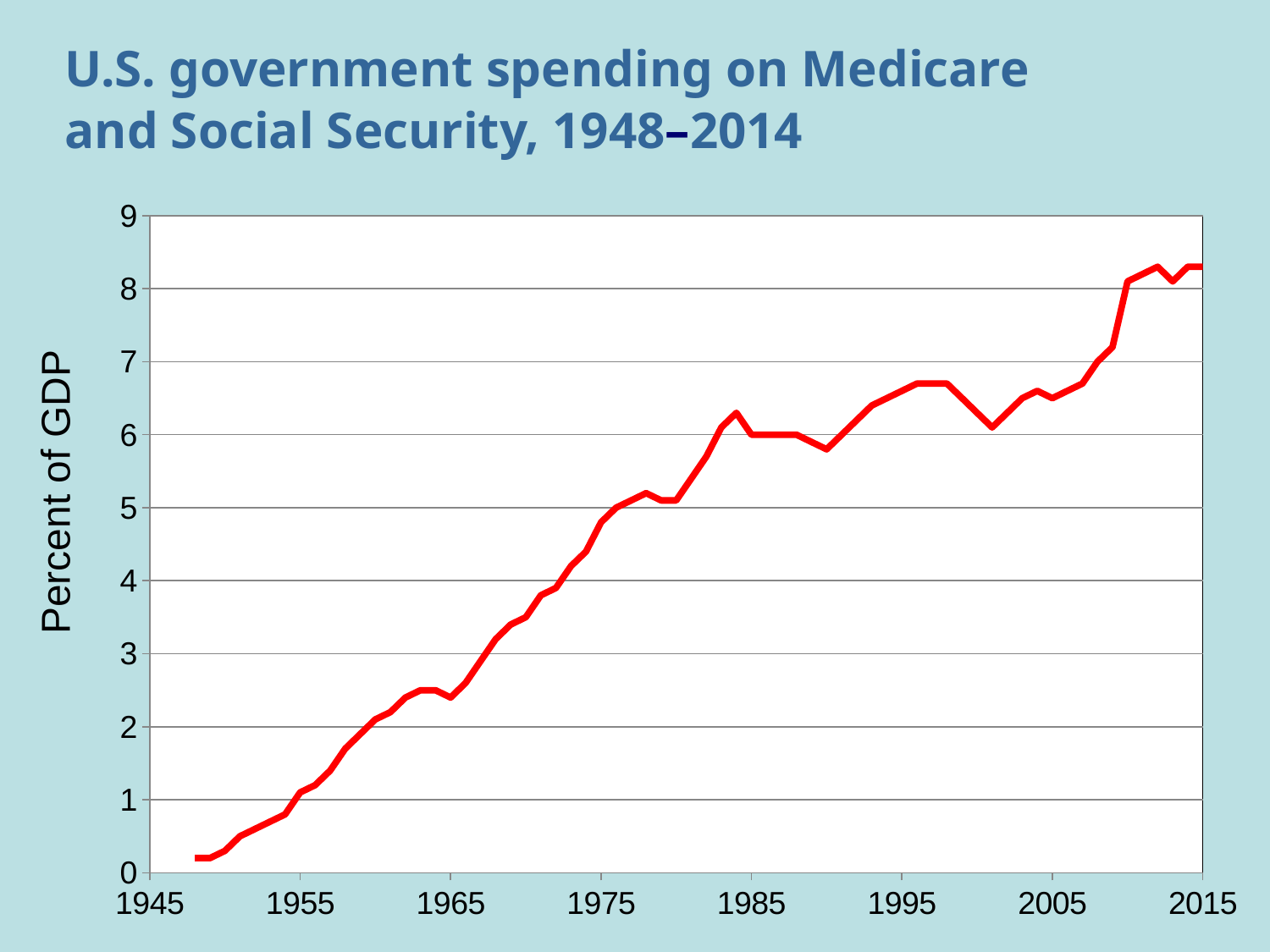
Overall, do the values rise or fall from 1948 to 2014? rise What is the label on the vertical axis of the chart? Percent of GDP Is the value for 1995 greater or less than 7? less Is the value for 1955 greater or less than 2? less Is the value for 2015 greater or less than 8? greater Which is larger, the value for 1985 or the value for 2005? 2005 What is the title of the chart? U.S. government spending on Medicare and Social Security, 1948–2014 What kind of chart is shown on the slide? line chart Which is larger, the value for 1965 or the value for 1975? 1975